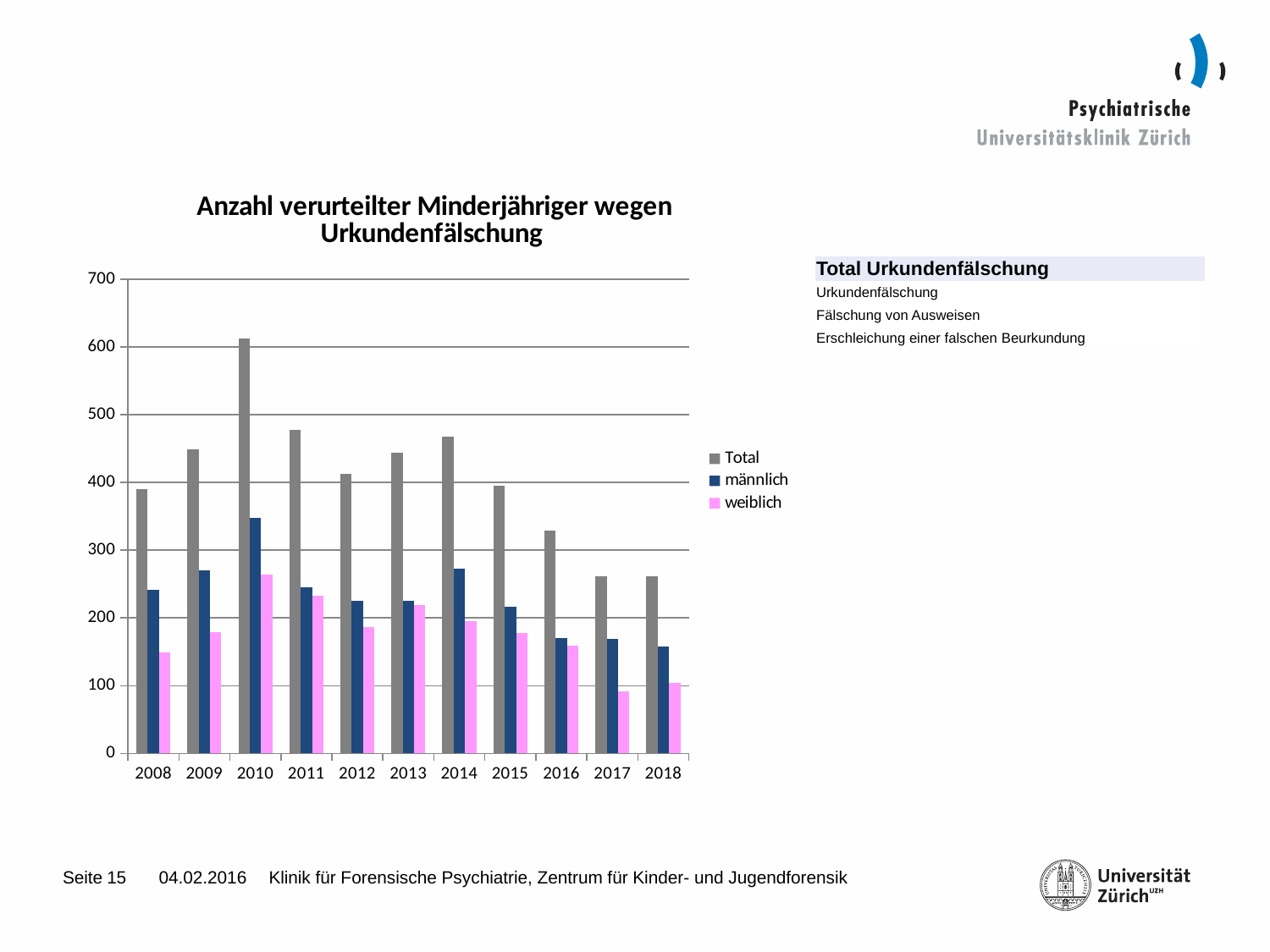
What is the title of the chart? Anzahl verurteilter Minderjähriger wegen Urkundenfälschung In which year is the männlich value highest? 2010 Do the Total values rise or fall from 2014 to 2018? fall Which is larger, the Total value for 2010 or for 2011? 2010 In which year is the Total value highest? 2010 Is the weiblich value for 2017 greater or less than 100? less How many series does the legend list? 3 In which year is the weiblich value lowest? 2017 What kind of chart is shown on the slide? bar chart Is the männlich value for 2010 greater or less than 300? greater How many years are shown on the x axis? 11 Is the Total value for 2010 greater or less than 600? greater